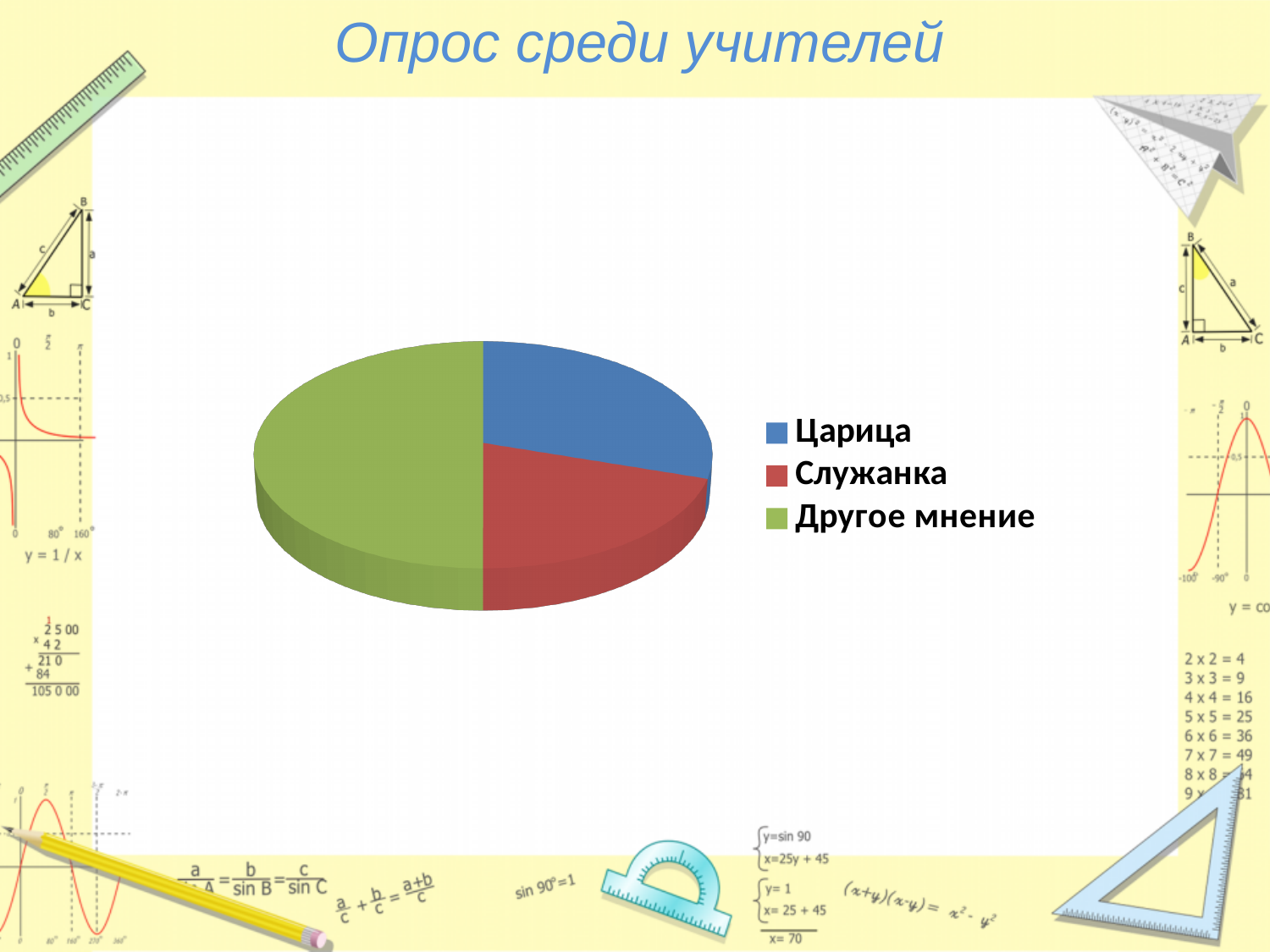
Which category has the largest slice in the pie chart? Другое мнение What is the title of the slide containing the pie chart? Опрос среди учителей How many entries does the legend of the pie chart list? 3 Which slice is larger: Служанка or Другое мнение? Другое мнение What kind of chart is shown on the slide? pie chart Which slice is larger: Другое мнение or Царица? Другое мнение How many slices does the pie chart have? 3 What colour is the slice for Царица in the pie chart? blue